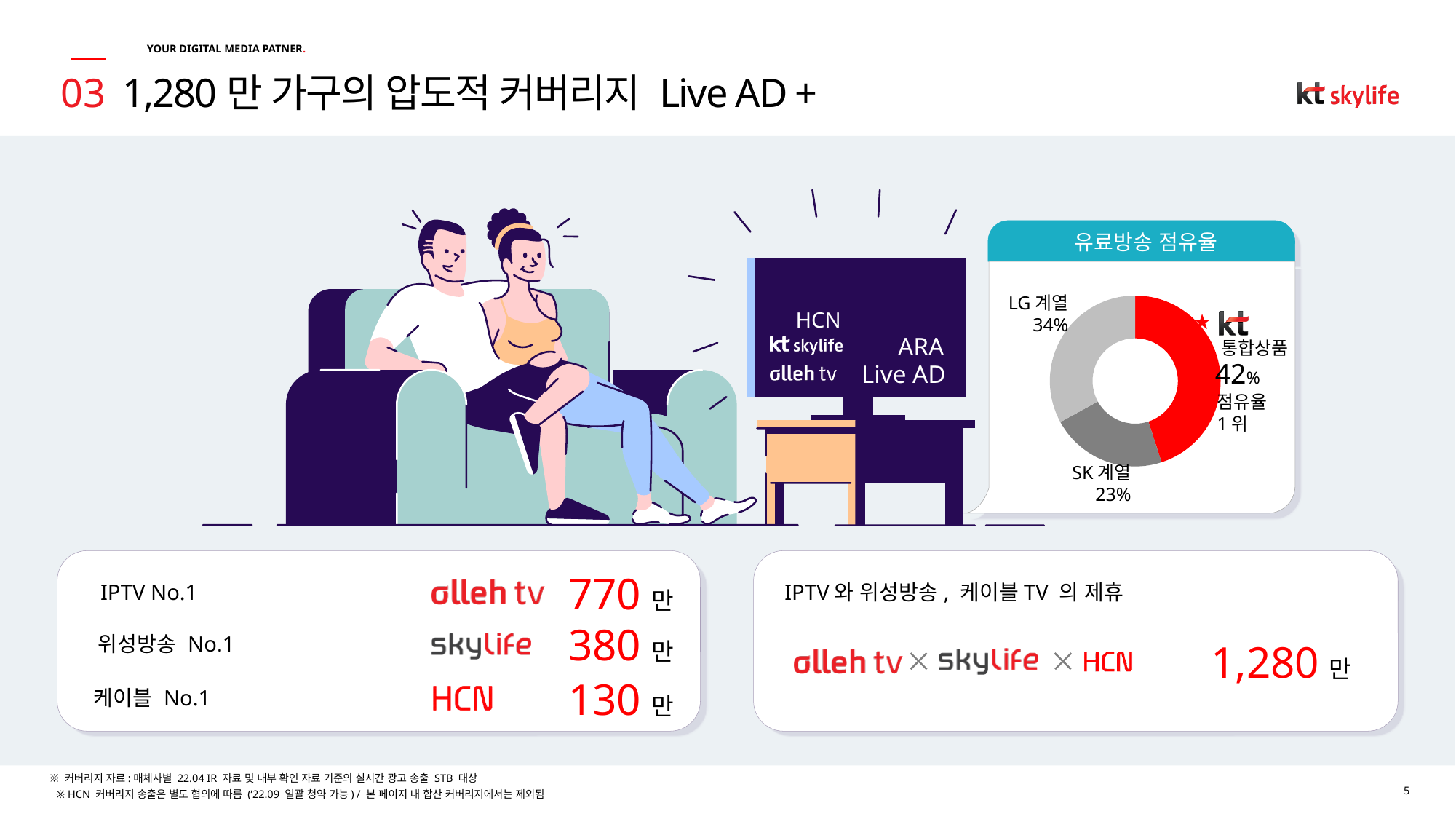
Which slice of the 유료방송 점유율 chart is coloured red? kt 통합상품 In the 유료방송 점유율 chart, which is larger: the LG 계열 share or the SK 계열 share? LG 계열 In the 유료방송 점유율 chart, what is the difference between the LG 계열 share and the SK 계열 share? 11 percentage points In the 유료방송 점유율 chart, what share does kt 통합상품 hold? 42% How many slices does the 유료방송 점유율 donut chart have? 3 What kind of chart is shown under the title 유료방송 점유율? Donut (pie) chart Which group has the smallest share in the 유료방송 점유율 chart? SK 계열 What is the title of the donut chart on the slide? 유료방송 점유율 Which group has the largest share in the 유료방송 점유율 chart? kt 통합상품 In the 유료방송 점유율 chart, how many percentage points larger is the kt 통합상품 share than the LG 계열 share? 8 In the 유료방송 점유율 chart, what share does LG 계열 hold? 34% In the 유료방송 점유율 chart, what share does SK 계열 hold? 23%